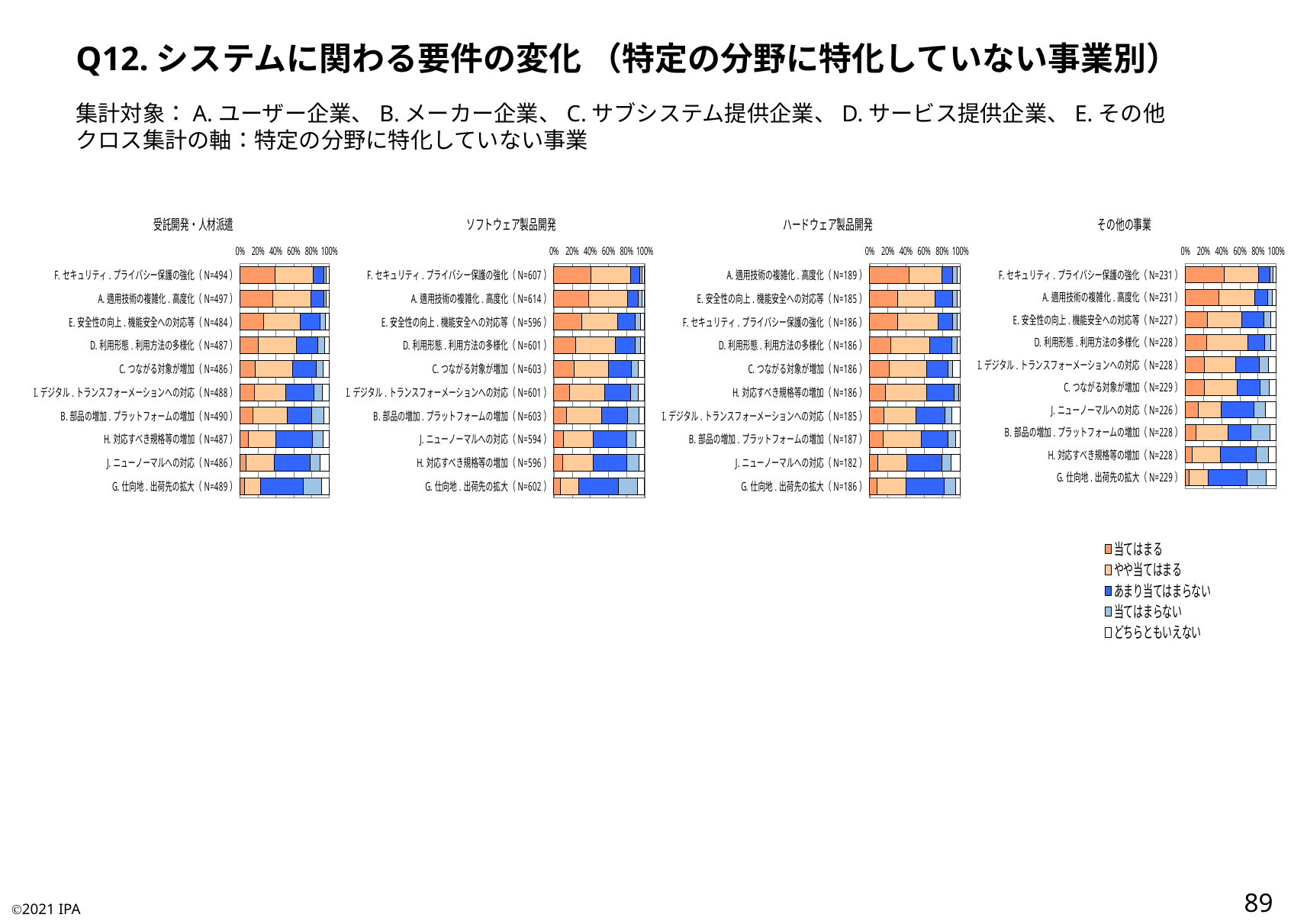
How many charts are shown on the slide? 4 How many categories does the ソフトウェア製品開発 chart show? 10 What kind of chart is the 受託開発・人材派遣 chart? stacked bar chart What is the title of the rightmost chart? その他の事業 In the その他の事業 chart, is the 当てはまる value for G. 仕向地・出荷先の拡大 greater or less than 20%? less How many series does the legend list? 5 In the ソフトウェア製品開発 chart, is the 当てはまる value for G. 仕向地・出荷先の拡大 greater or less than 20%? less How many categories does the ハードウェア製品開発 chart show? 10 In the ハードウェア製品開発 chart, is the 当てはまる value for J. ニューノーマルへの対応 greater or less than 20%? less In the 受託開発・人材派遣 chart, which has the larger 当てはまる value: F. セキュリティ・プライバシー保護の強化 or G. 仕向地・出荷先の拡大? F. セキュリティ・プライバシー保護の強化 Which legend entry is shown in dark blue? あまり当てはまらない